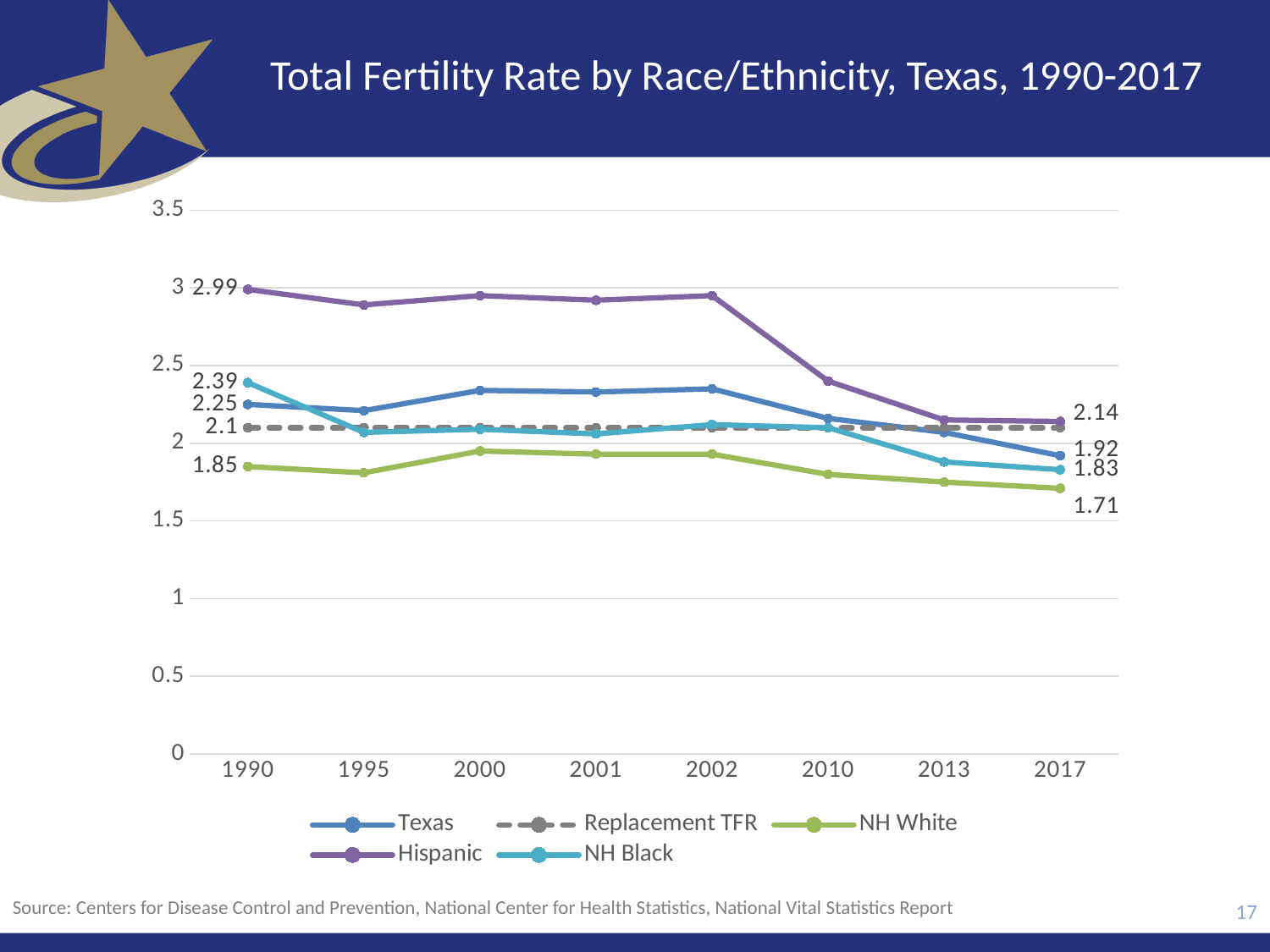
Does the Hispanic total fertility rate rise or fall from 2002 to 2017? fall Which series has the highest total fertility rate in 1990? Hispanic Is the Hispanic value in 2010 greater or less than 2.5? less Which series has the lowest total fertility rate in 2017? NH White How many series does the legend list? 5 What kind of chart is shown on the slide? line chart What is the total fertility rate for Hispanic in 1990? 2.99 In 1990, which is higher: the Texas rate or the NH Black rate? NH Black What is the value for NH Black in 1990? 2.39 What is the total fertility rate for NH White in 2017? 1.71 By how much did the Hispanic total fertility rate fall from 1990 to 2017? 0.85 How many years are shown on the x axis? 8